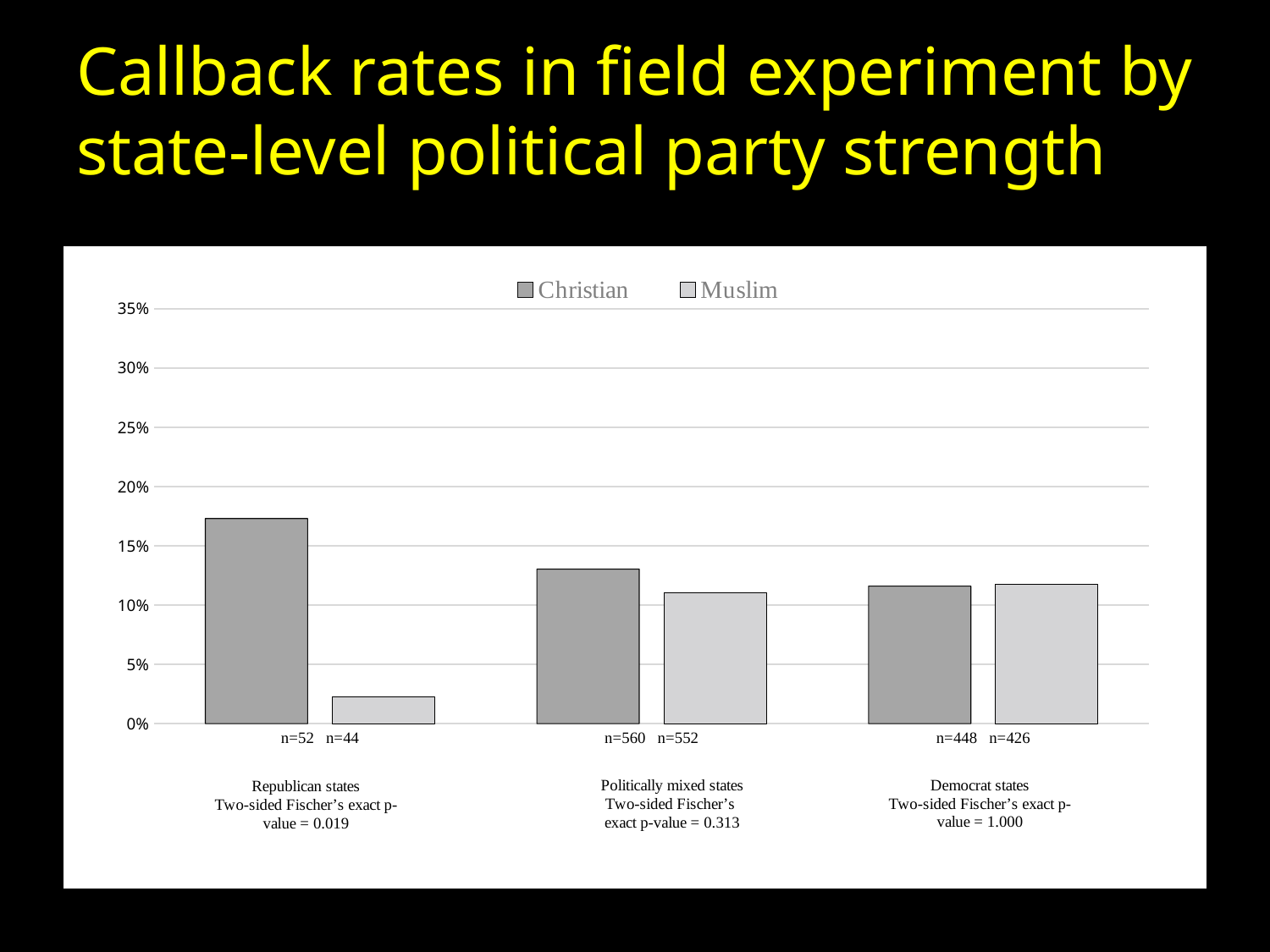
Is the Christian callback rate in Republican states greater or less than 15%? greater In Republican states, which series has the higher callback rate, Christian or Muslim? Christian In Politically mixed states, which series has the higher callback rate, Christian or Muslim? Christian How many series does the legend list? 2 What are the two entries in the chart legend? Christian and Muslim What is the two-sided Fischer's exact p-value shown for Republican states? 0.019 Which bar is the highest in the chart? Christian in Republican states Which bar is the lowest in the chart? Muslim in Republican states Is the Christian callback rate in Politically mixed states greater or less than 10%? greater Is the Muslim callback rate in Republican states greater or less than 5%? less What kind of chart is shown on the slide? bar chart How many state categories are shown along the x axis? 3